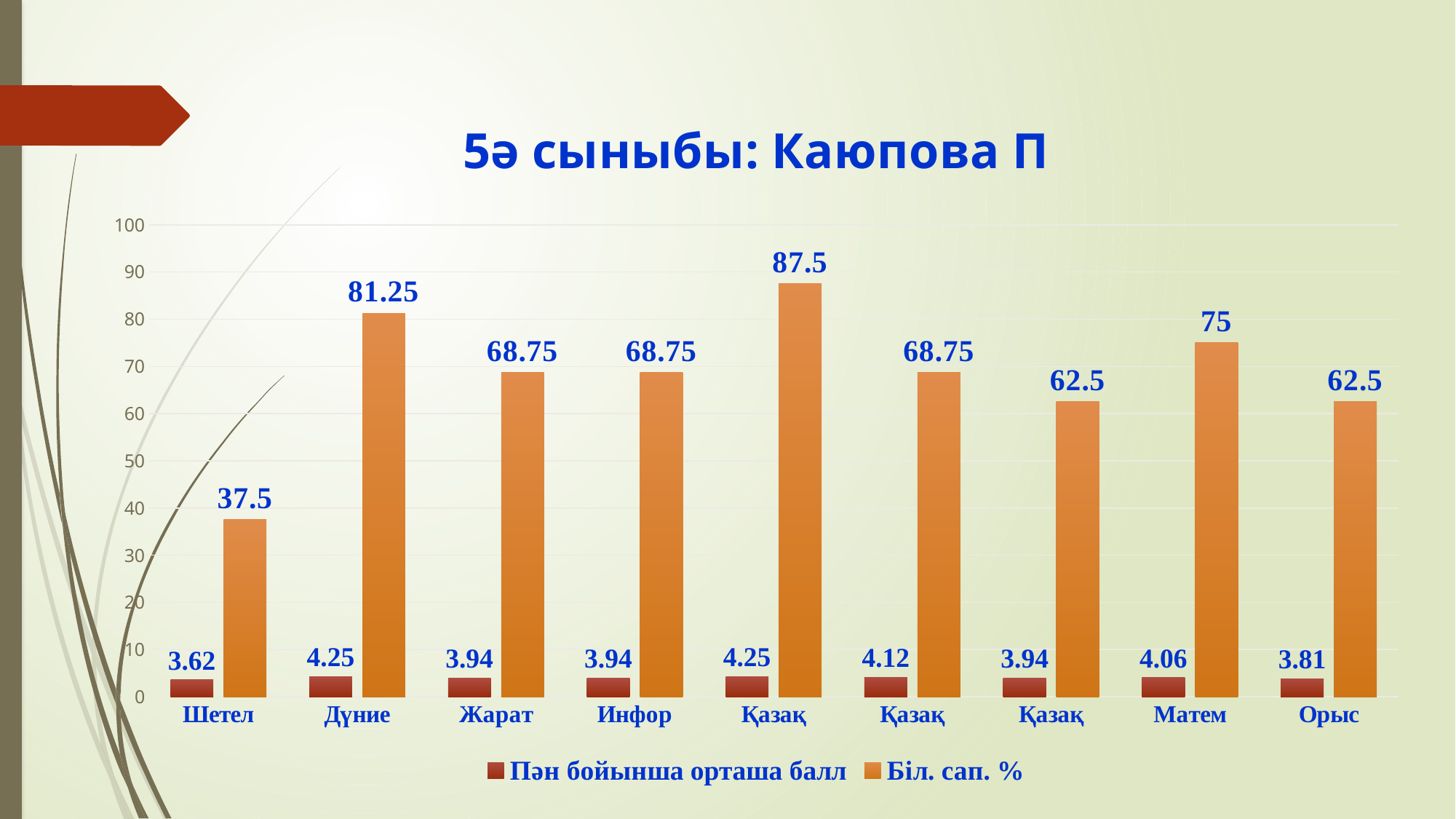
What is the difference between the Біл. сап. % values for Дүние and Шетел? 43.75 What is the value of Біл. сап. % for Матем? 75 What is the value of Пән бойынша орташа балл for Орыс? 3.81 How many series does the legend list? 2 What is the value of Пән бойынша орташа балл for Дүние? 4.25 Is the Біл. сап. % value for Шетел greater or less than 40? less What is the highest value of Біл. сап. % shown on the chart? 87.5 How many categories are shown on the x axis? 9 What is the value of Біл. сап. % for Шетел? 37.5 What kind of chart is shown on the slide? bar chart Which category has the lowest value of Біл. сап. %? Шетел Which has a higher Біл. сап. % value, Матем or Орыс? Матем